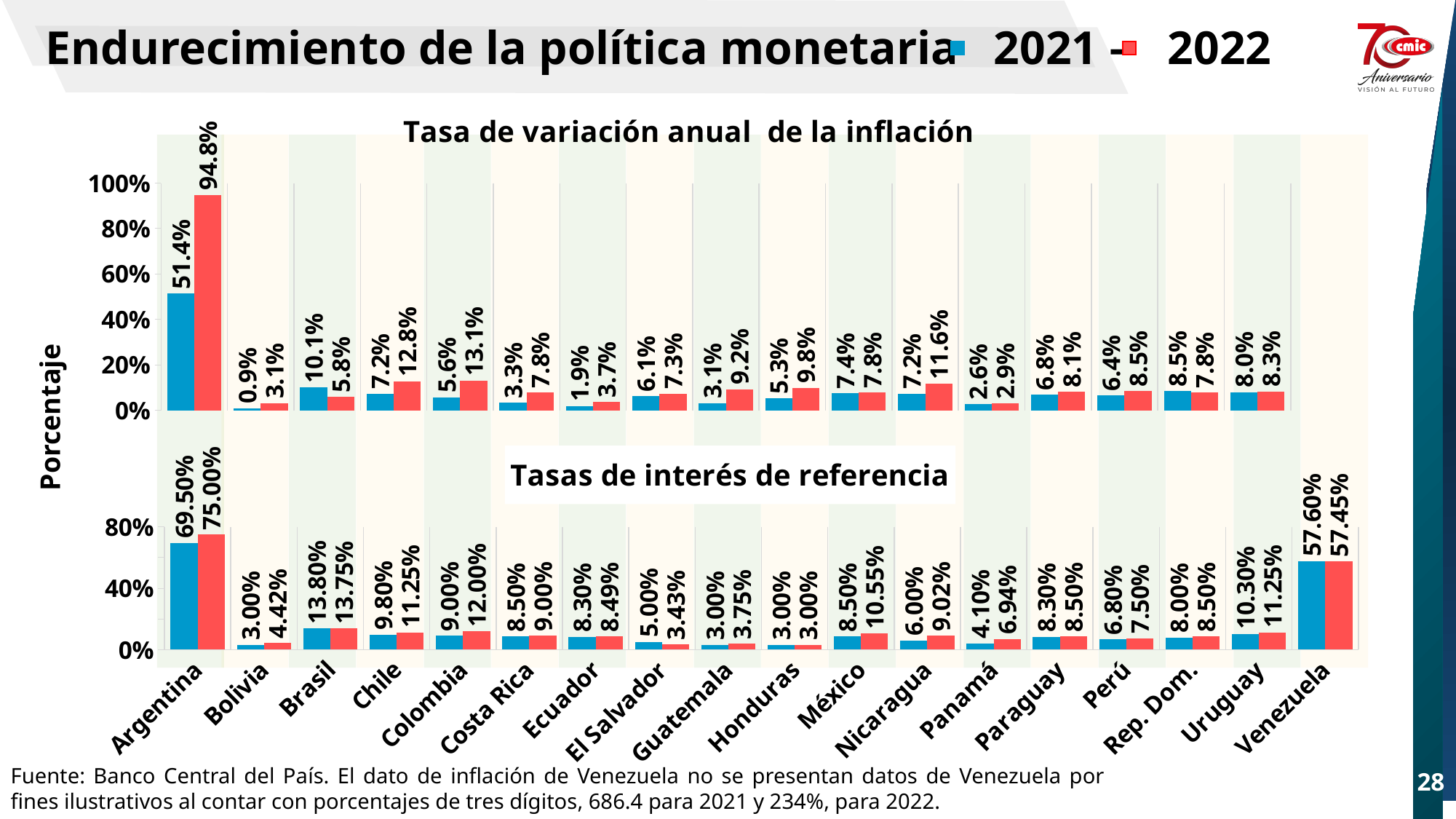
In the 'Tasas de interés de referencia' chart, which country has the highest 2022 value? Argentina How many series does the legend list for the charts on this slide? 2 In the 'Tasas de interés de referencia' chart, what is the 2021 value for Venezuela? 57.60% In the 'Tasa de variación anual de la inflación' chart, what is the 2022 value for Argentina? 94.8% In the 'Tasa de variación anual de la inflación' chart, is the 2021 value for Argentina greater or less than 40%? greater In the 'Tasa de variación anual de la inflación' chart, what is the 2021 value for Colombia? 5.6% In the 'Tasa de variación anual de la inflación' chart, which country has the lowest 2021 value? Bolivia In the 'Tasa de variación anual de la inflación' chart, what is the difference between the 2022 and 2021 values for Chile? 5.6% In the 'Tasas de interés de referencia' chart, what is the difference between the 2022 and 2021 values for Panamá? 2.84% In the 'Tasa de variación anual de la inflación' chart, is the 2021 value for Brasil larger or the 2022 value? 2021 How many countries are shown in the 'Tasas de interés de referencia' chart? 18 In the 'Tasas de interés de referencia' chart, what is the 2022 value for México? 10.55%